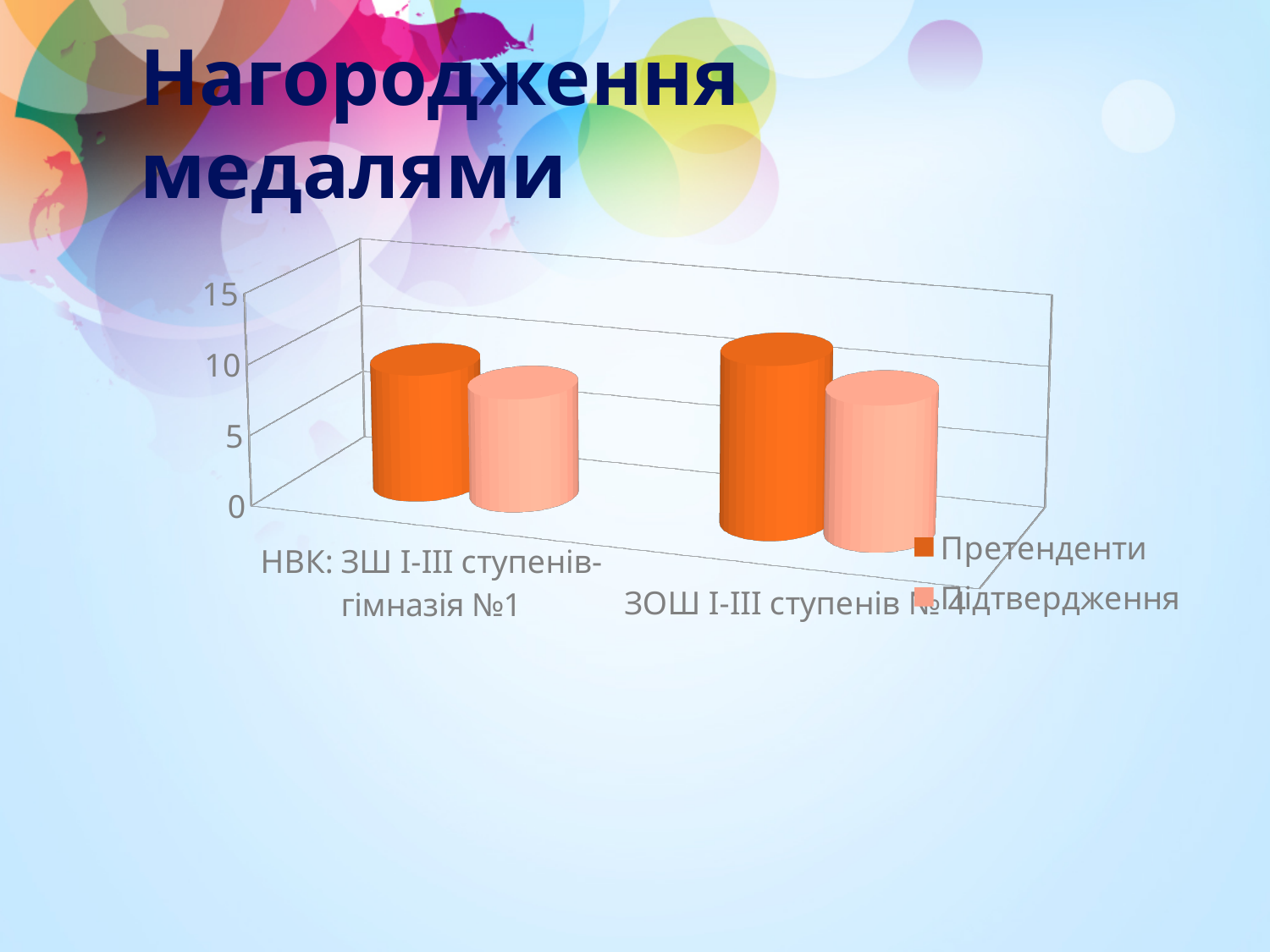
Is the Претенденти value for ЗОШ І-ІІІ ступенів №4 greater or less than 10? greater Which school has the lower value for Підтвердження? НВК: ЗШ І-ІІІ ступенів-гімназія №1 What kind of chart is shown on the slide? Bar chart Which is larger: the Претенденти value for ЗОШ І-ІІІ ступенів №4 or the Претенденти value for НВК: ЗШ І-ІІІ ступенів-гімназія №1? ЗОШ І-ІІІ ступенів №4 What is the title of the slide containing the chart? Нагородження медалями Which school has the higher value for Претенденти? ЗОШ І-ІІІ ступенів №4 What are the two series named in the chart legend? Претенденти and Підтвердження For ЗОШ І-ІІІ ступенів №4, which is larger: Претенденти or Підтвердження? Претенденти How many series does the chart legend list? 2 Is the Претенденти value for НВК: ЗШ І-ІІІ ступенів-гімназія №1 greater or less than 5? greater Is the Підтвердження value for НВК: ЗШ І-ІІІ ступенів-гімназія №1 greater or less than 15? less How many school categories are shown on the x axis of the chart? 2